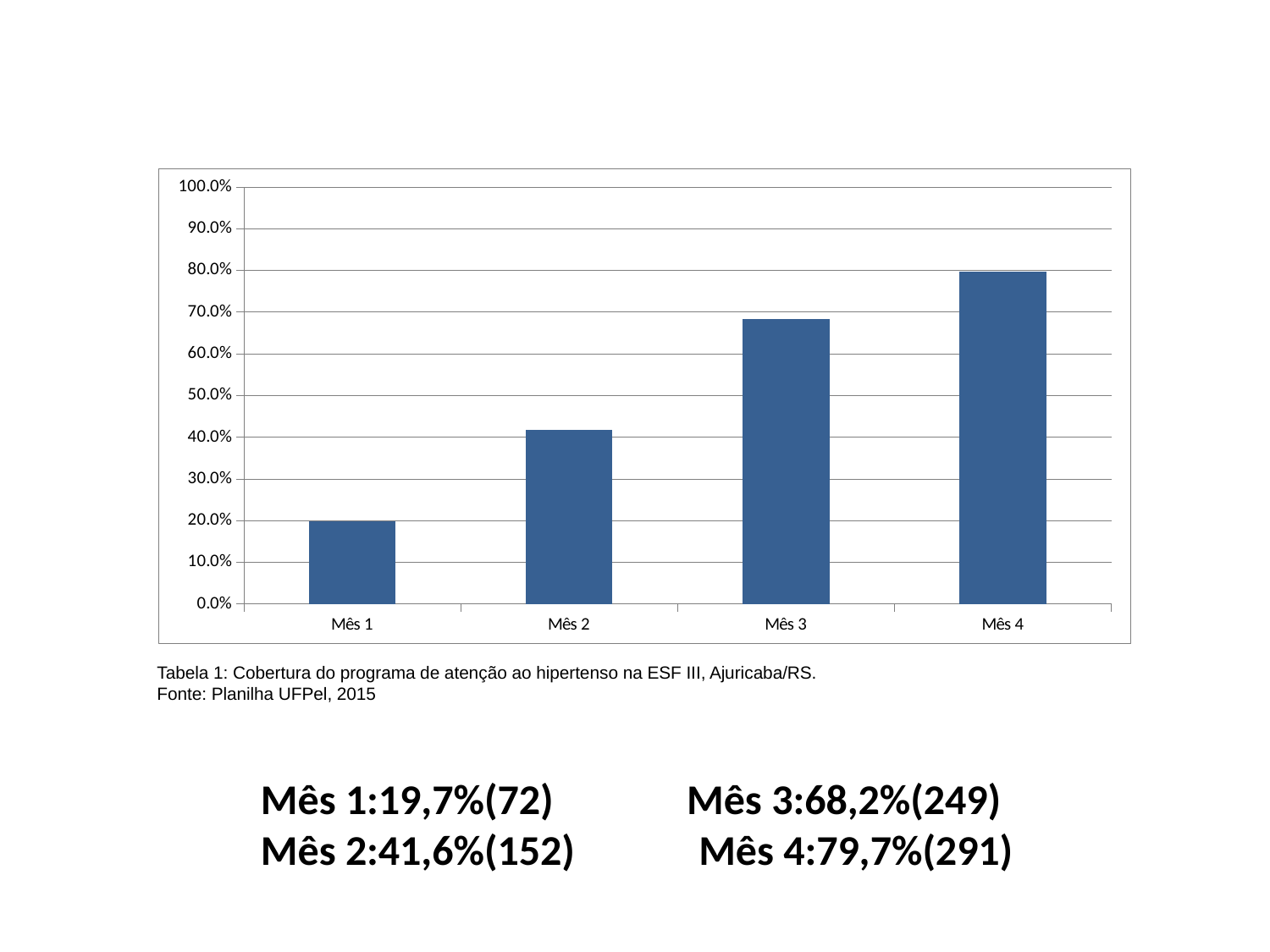
Is the value for Mês 3 greater or less than 60.0%? greater Do the values rise or fall from Mês 1 to Mês 4? rise According to the slide, what is the coverage value for Mês 1? 19,7% Which is larger, the value for Mês 3 or the value for Mês 2? Mês 3 What is the difference in percentage points between the values for Mês 4 and Mês 1 given on the slide? 60,0 Which month has the lowest bar in the chart? Mês 1 According to the slide, what is the coverage value for Mês 4? 79,7% Is the value for Mês 2 greater or less than 50.0%? less How many bars (categories) does the chart show? 4 What kind of chart is shown on the slide? bar chart According to the slide, what is the coverage value for Mês 2? 41,6% Which month has the highest bar in the chart? Mês 4